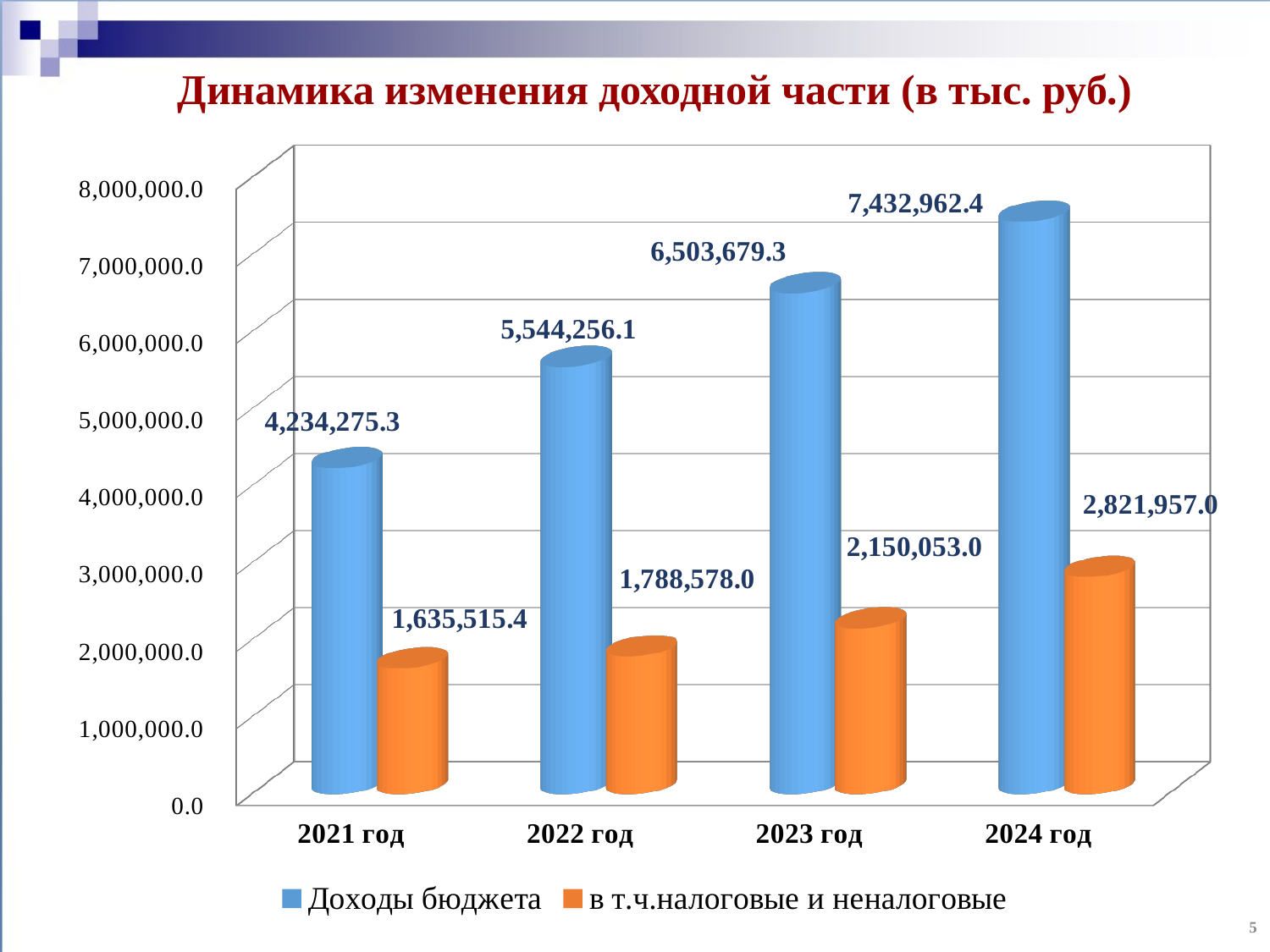
Which year has the lowest value for в т.ч.налоговые и неналоговые? 2021 год What kind of chart is shown on the slide? Bar chart How many years are shown on the x axis? 4 Which is larger: в т.ч.налоговые и неналоговые in 2022 год or in 2023 год? 2023 год Which year has the highest value for Доходы бюджета? 2024 год How many series does the legend list? 2 What is the value of Доходы бюджета for 2023 год? 6,503,679.3 What is the difference between Доходы бюджета and в т.ч.налоговые и неналоговые in 2021 год? 2,598,759.9 Do the values for Доходы бюджета rise or fall from 2021 год to 2024 год? Rise What is the value of в т.ч.налоговые и неналоговые for 2024 год? 2,821,957.0 What is the value of в т.ч.налоговые и неналоговые for 2021 год? 1,635,515.4 What is the difference between Доходы бюджета in 2024 год and 2023 год? 929,283.1